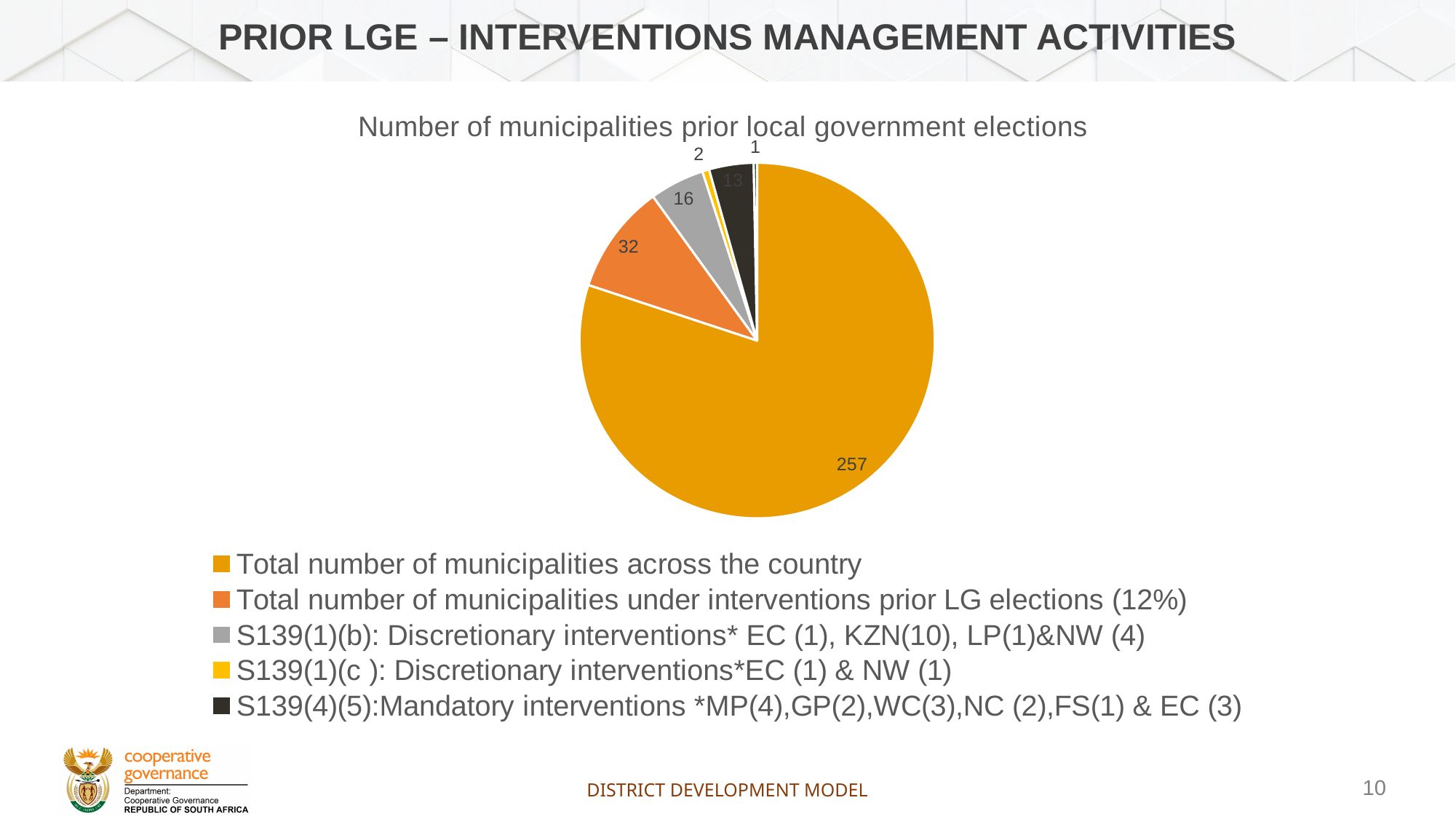
What value is shown for 'S139(1)(b): Discretionary interventions* EC (1), KZN(10), LP(1)&NW (4)'? 16 Which is larger: the value for 'S139(4)(5):Mandatory interventions' or the value for 'S139(1)(c ): Discretionary interventions'? S139(4)(5):Mandatory interventions What value is shown for 'Total number of municipalities under interventions prior LG elections (12%)'? 32 What is the title of the chart? Number of municipalities prior local government elections What value is shown for 'S139(1)(c ): Discretionary interventions*EC (1) & NW (1)'? 2 Which legend category has the largest slice of the pie? Total number of municipalities across the country What value is shown for 'S139(4)(5):Mandatory interventions *MP(4),GP(2),WC(3),NC (2),FS(1) & EC (3)'? 13 What is the difference between the value for 'S139(1)(b): Discretionary interventions' and the value for 'S139(4)(5):Mandatory interventions'? 3 What value is shown for 'Total number of municipalities across the country'? 257 How many entries does the chart legend list? 5 What kind of chart is shown on the slide? Pie chart What is the difference between the value for 'Total number of municipalities across the country' and the value for 'Total number of municipalities under interventions prior LG elections (12%)'? 225